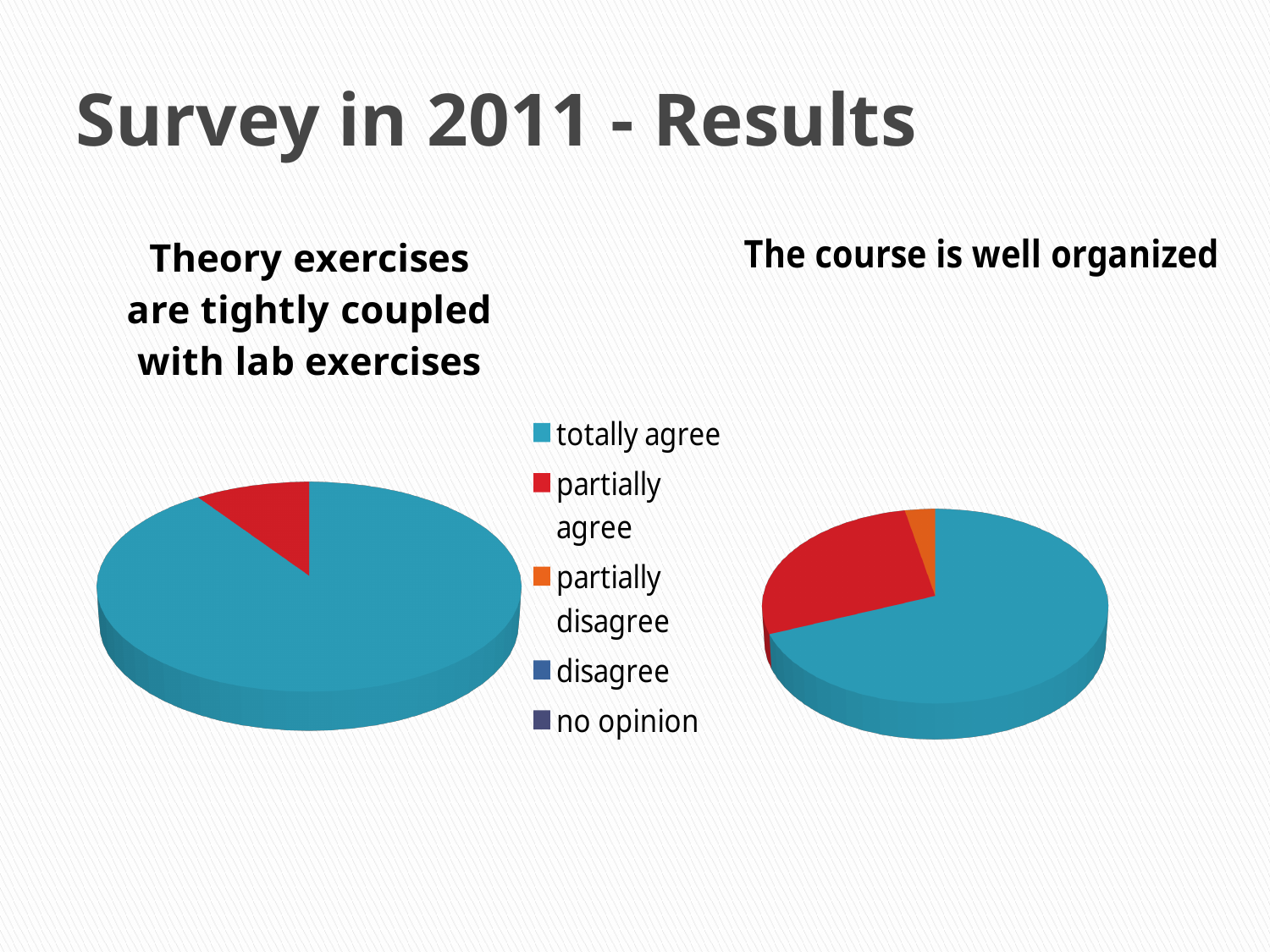
How many categories does the shared legend list? 5 How many slices are visible in the "The course is well organized" pie chart? 3 What is the title of the chart on the right side of the slide? The course is well organized In the "The course is well organized" chart, which is larger: the "partially agree" slice or the "partially disagree" slice? partially agree What colour represents "totally agree" in the legend? blue In the "The course is well organized" chart, which category has the smallest visible slice? partially disagree How many slices are visible in the "Theory exercises are tightly coupled with lab exercises" pie chart? 2 In the "Theory exercises are tightly coupled with lab exercises" chart, which category has the largest slice? totally agree In the "The course is well organized" chart, which category has the largest slice? totally agree What kind of chart is the "The course is well organized" chart? pie chart What kind of chart is the "Theory exercises are tightly coupled with lab exercises" chart? pie chart In the "Theory exercises are tightly coupled with lab exercises" chart, which is larger: the "totally agree" slice or the "partially agree" slice? totally agree